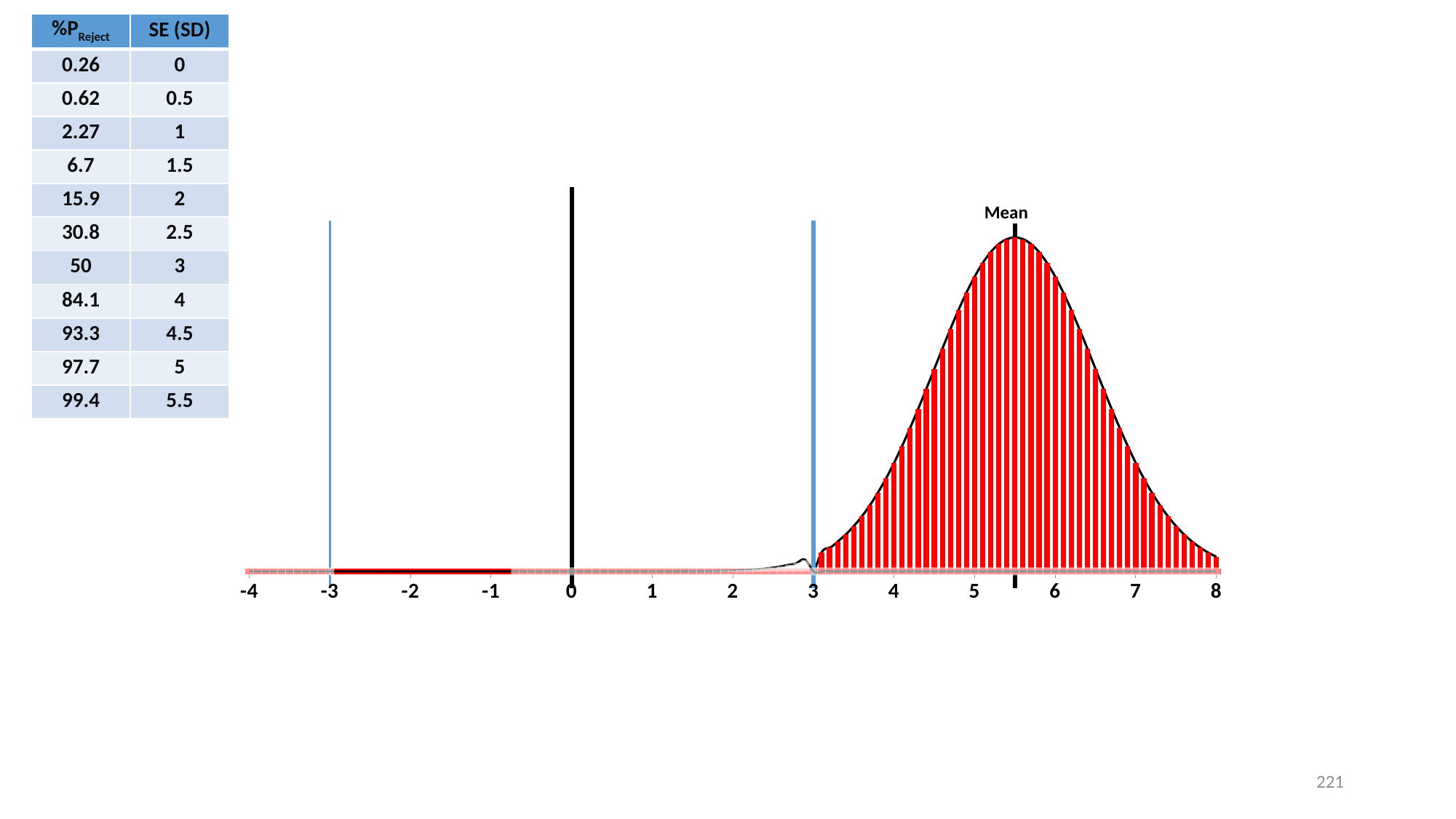
At which x-axis value is the thick black vertical line drawn on the chart? 0 Is the x-axis position of the Mean marker on the chart greater or less than 6? less How many tick labels are shown on the x axis of the chart? 13 Do the red bars rise or fall as the x axis moves from 3 toward the Mean marker? rise What is the highest value labelled on the x axis of the chart? 8 Do the red bars rise or fall as the x axis moves from the Mean marker toward 8? fall Is the x-axis position of the Mean marker on the chart greater or less than 5? greater Which is taller on the chart, the red bar at x = 4 or the red bar at x = 7? Neither; they are the same height At which x-axis values are the two blue vertical lines drawn on the chart? -3 and 3 What is the lowest value labelled on the x axis of the chart? -4 What kind of chart is shown on the slide? bar chart What label is printed above the peak of the red distribution on the chart? Mean